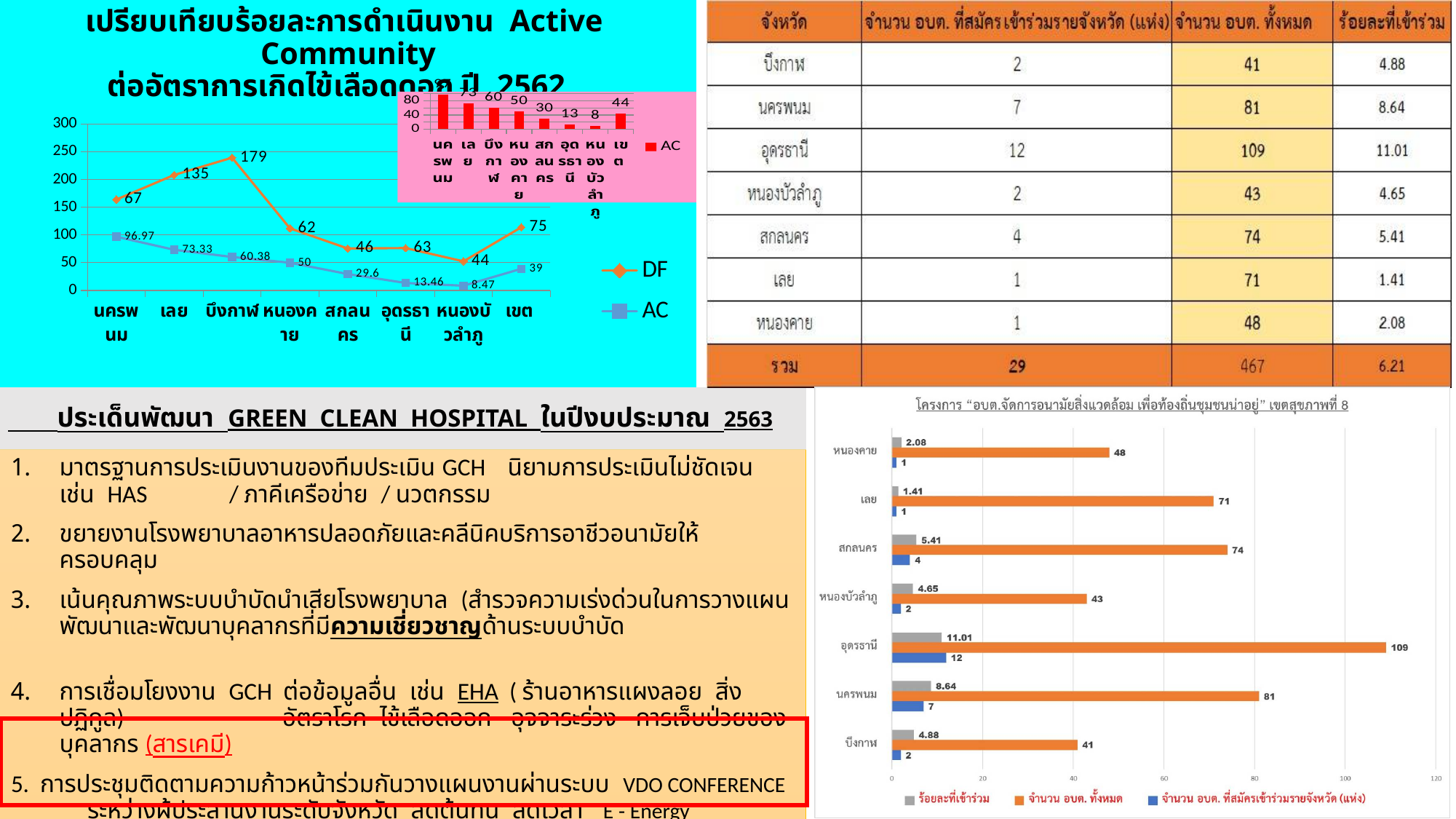
In the top-left line chart, which category has the lowest AC value? หนองบัวลำภู In the top-left line chart, how many series does the legend list? 2 What kind of chart is the bottom-right chart? bar chart In the top-left line chart, how many categories are shown on the x axis? 8 In the bottom-right bar chart, which is larger: the จำนวน อบต. ทั้งหมด value for เลย or for หนองคาย? เลย In the top-left line chart, what is the DF value for บึงกาฬ? 179 In the top-left line chart, what is the difference between the DF values for เลย and นครพนม? 68 In the bottom-right bar chart, which province has the highest จำนวน อบต. ที่สมัครเข้าร่วมรายจังหวัด (แห่ง) value? อุดรธานี In the bottom-right bar chart, what is the จำนวน อบต. ทั้งหมด value for อุดรธานี? 109 In the top-left line chart, which category has the highest DF value? บึงกาฬ In the bottom-right bar chart, what is the ร้อยละที่เข้าร่วม value for นครพนม? 8.64 In the top-left line chart, what is the AC value for นครพนม? 96.97